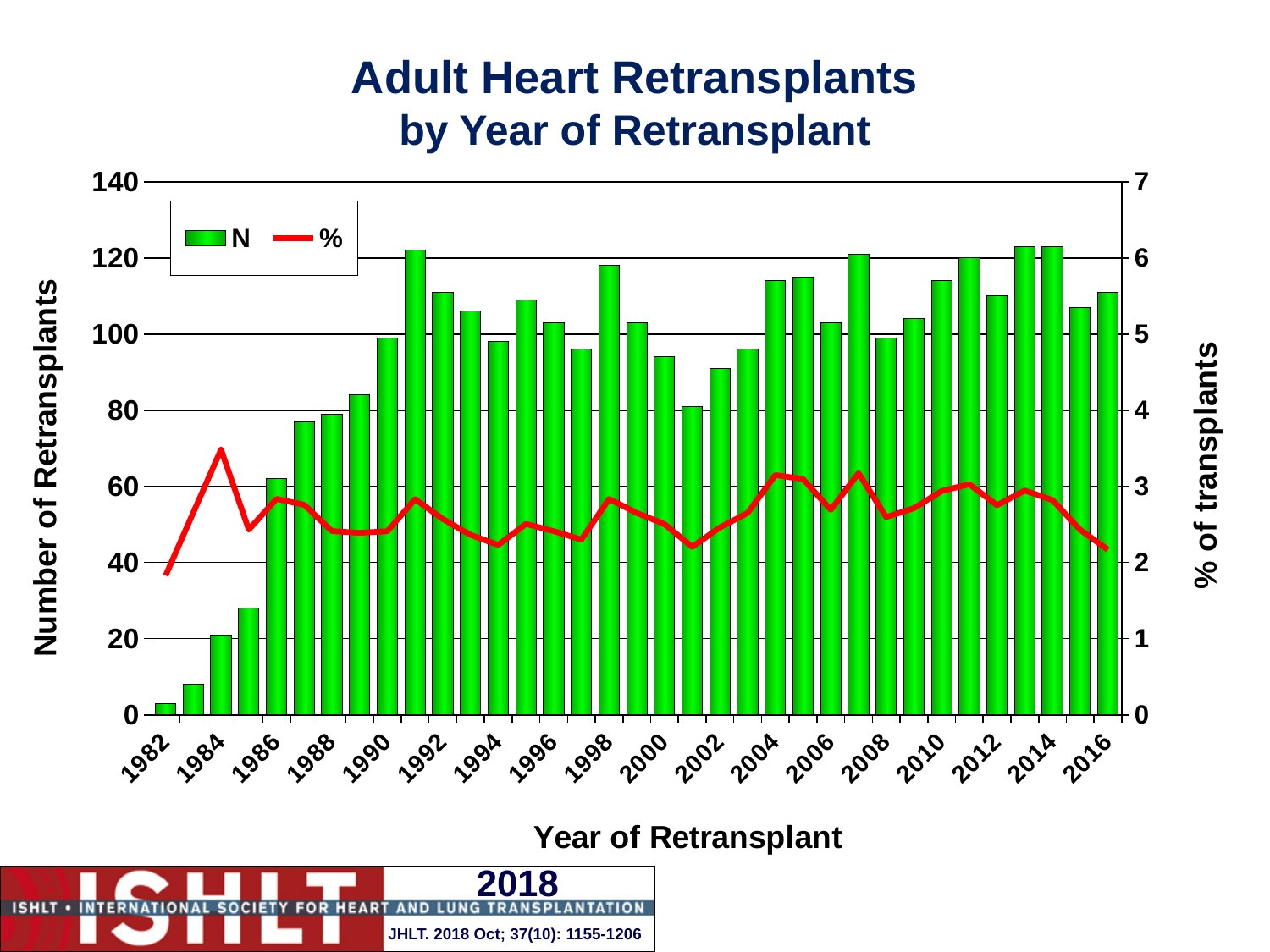
Do the number of retransplants generally rise or fall from 1982 to 1991? rise Is the number of retransplants in 2001 greater or less than 100? less In which year does the % of transplants line reach its highest point? 1984 What kind of chart is shown on the slide? A combined bar and line chart Is the number of retransplants in 1998 greater or less than 100? greater Is the number of retransplants in 1983 greater or less than 20? less What are the two entries in the chart legend? N and % How many series does the legend list? 2 What is the title of the chart? Adult Heart Retransplants by Year of Retransplant Which year has more retransplants, 1998 or 2002? 1998 Which year has the lowest number of retransplants (shortest bar)? 1982